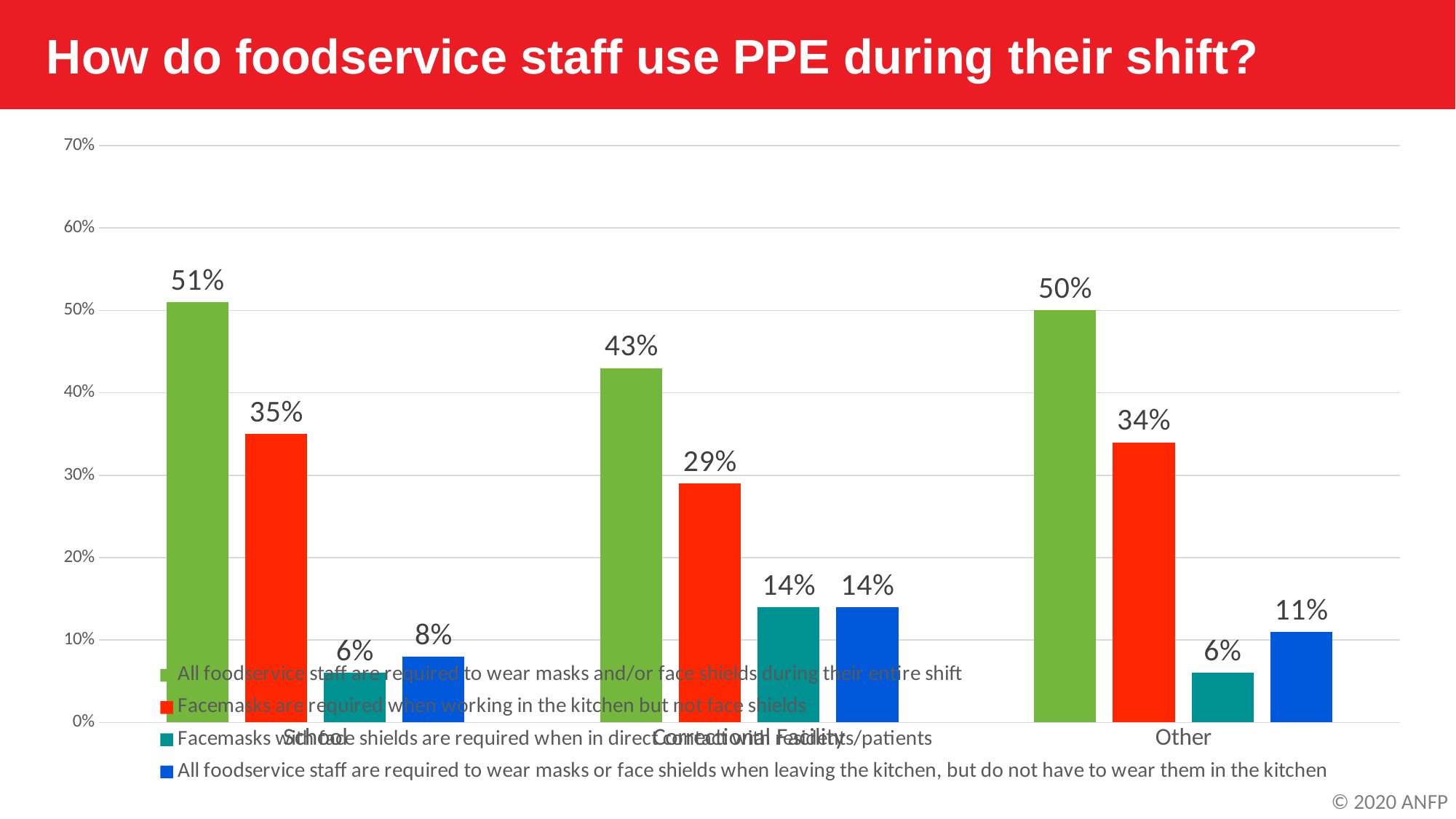
What is the value for 'Facemasks are required when working in the kitchen but not face shields' in the Correctional Facility category? 29% Which category has the lowest value for 'Facemasks are required when working in the kitchen but not face shields'? Correctional Facility What is the title of the chart on the slide? How do foodservice staff use PPE during their shift? Is the value for 'All foodservice staff are required to wear masks and/or face shields during their entire shift' in the Correctional Facility category greater or less than 40%? greater How many categories are shown along the x axis? 3 Which category has the highest value for 'All foodservice staff are required to wear masks and/or face shields during their entire shift'? School How many series does the legend list? 4 Which is larger in the Correctional Facility category: the value for 'Facemasks are required when working in the kitchen but not face shields' or the value for 'Facemasks with face shields are required when in direct contact with residents/patients'? Facemasks are required when working in the kitchen but not face shields What kind of chart is shown on the slide? bar chart What is the difference between the School and Other values for 'Facemasks are required when working in the kitchen but not face shields'? 1% What is the value for 'All foodservice staff are required to wear masks or face shields when leaving the kitchen, but do not have to wear them in the kitchen' in the Other category? 11% What is the value for 'All foodservice staff are required to wear masks and/or face shields during their entire shift' in the School category? 51%